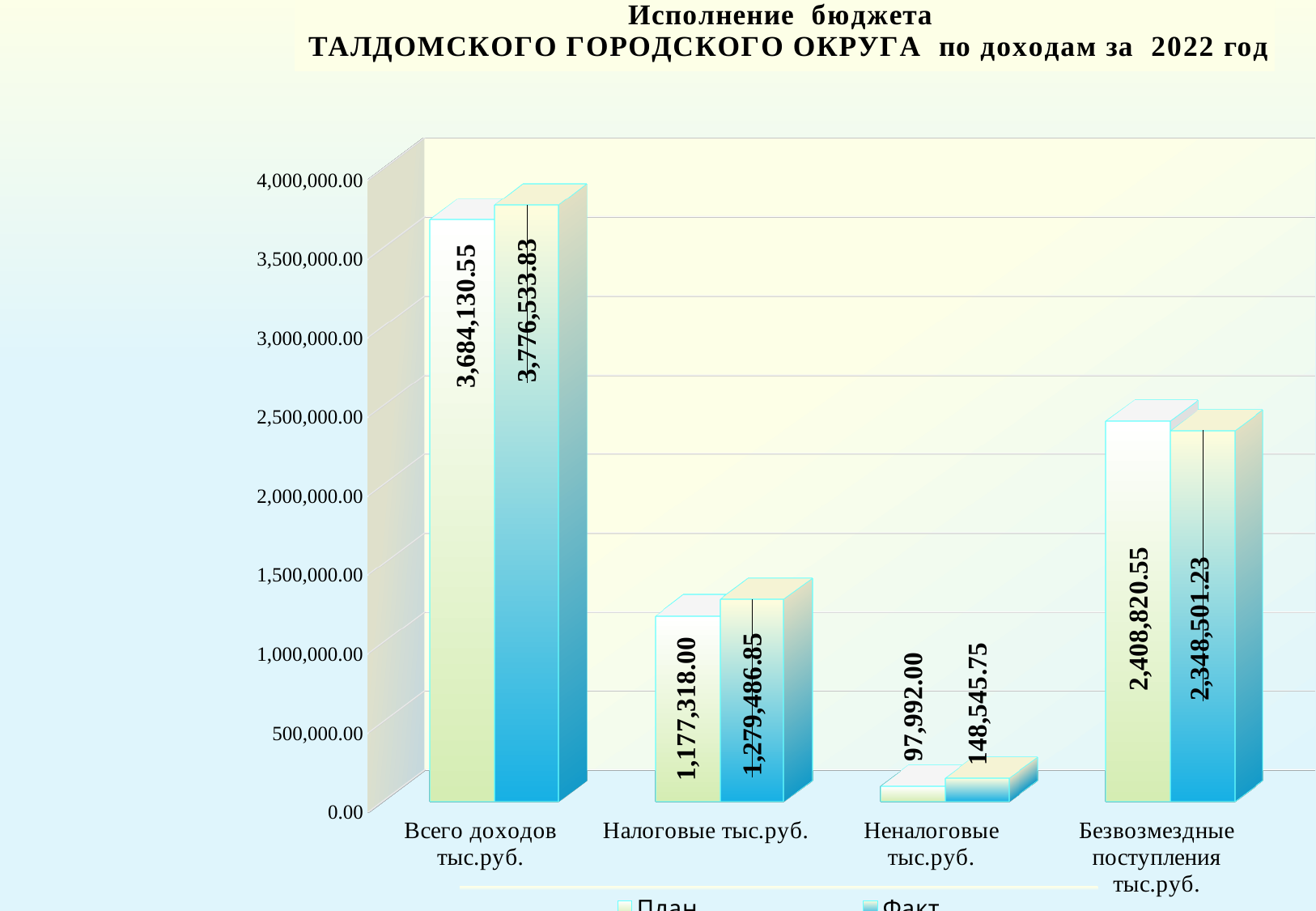
What is the Факт value for Безвозмездные поступления тыс.руб.? 2,348,501.23 What is the difference between the Факт and План values for Всего доходов тыс.руб.? 92,403.28 For Безвозмездные поступления тыс.руб., which is larger: План or Факт? План What is the difference between the Факт and План values for Неналоговые тыс.руб.? 50,553.75 What is the Факт value for Налоговые тыс.руб.? 1,279,486.85 How many series does the legend list? 2 How many categories are shown on the x axis? 4 Which category has the highest План value? Всего доходов тыс.руб. What kind of chart is shown on the slide? Bar chart Which category has the lowest Факт value? Неналоговые тыс.руб. What is the План value for Всего доходов тыс.руб.? 3,684,130.55 What is the План value for Неналоговые тыс.руб.? 97,992.00